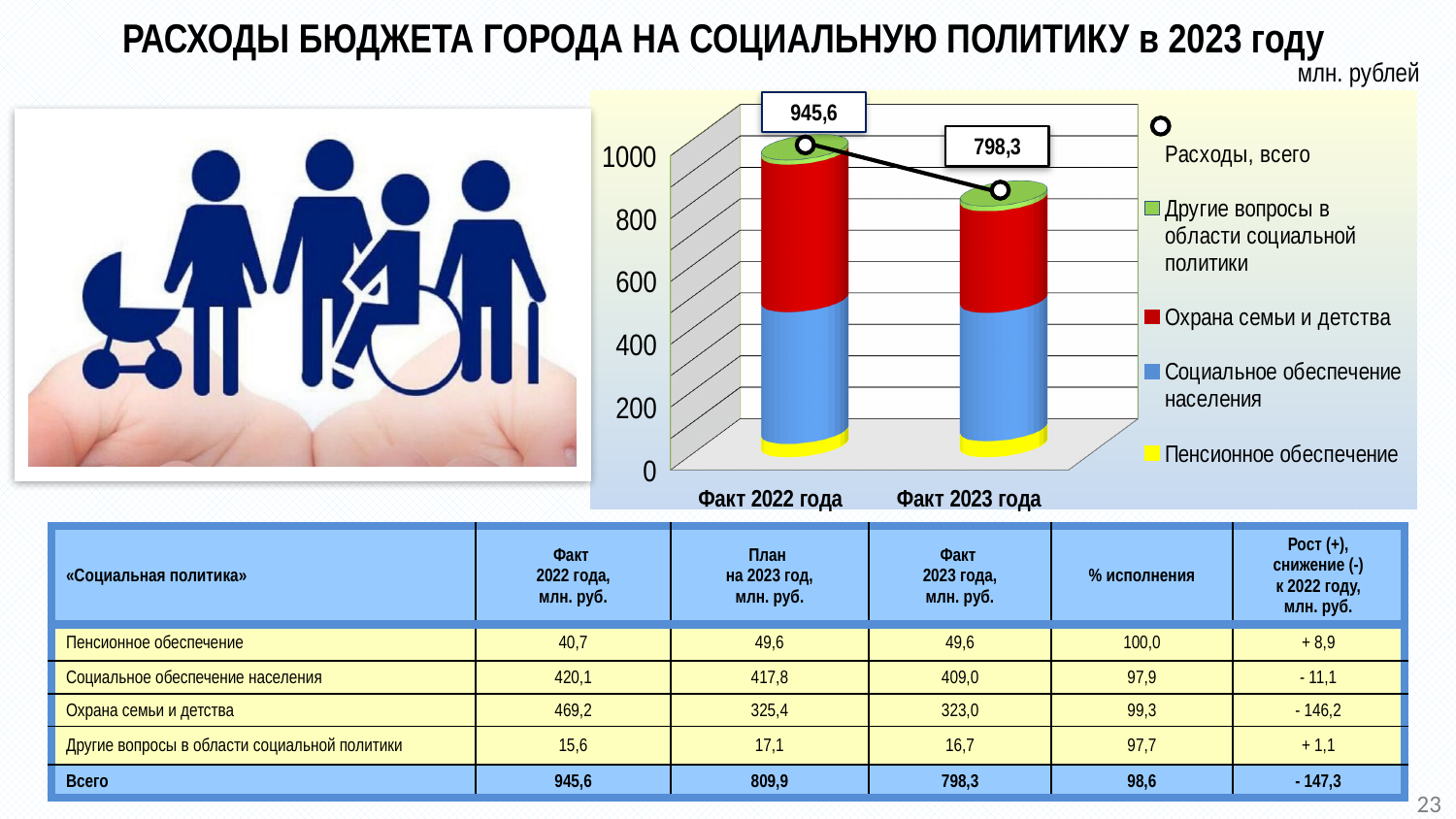
Do the total expenditures rise or fall from «Факт 2022 года» to «Факт 2023 года»? Fall Which category has the lowest total expenditure? Факт 2023 года How many entries does the chart legend list? 5 What kind of chart is shown on the slide? Stacked bar chart Which category has the higher total expenditure, «Факт 2022 года» or «Факт 2023 года»? Факт 2022 года In what units are the chart values given? млн. рублей What is the value of «Расходы, всего» for «Факт 2023 года»? 798,3 Which colour represents «Охрана семьи и детства» in the chart? Red What is the value of «Расходы, всего» for «Факт 2022 года»? 945,6 Is the total for «Факт 2023 года» greater or less than 1000? less What is the difference between the total for «Факт 2022 года» and the total for «Факт 2023 года»? 147,3 How many categories are plotted on the x axis of the chart? 2